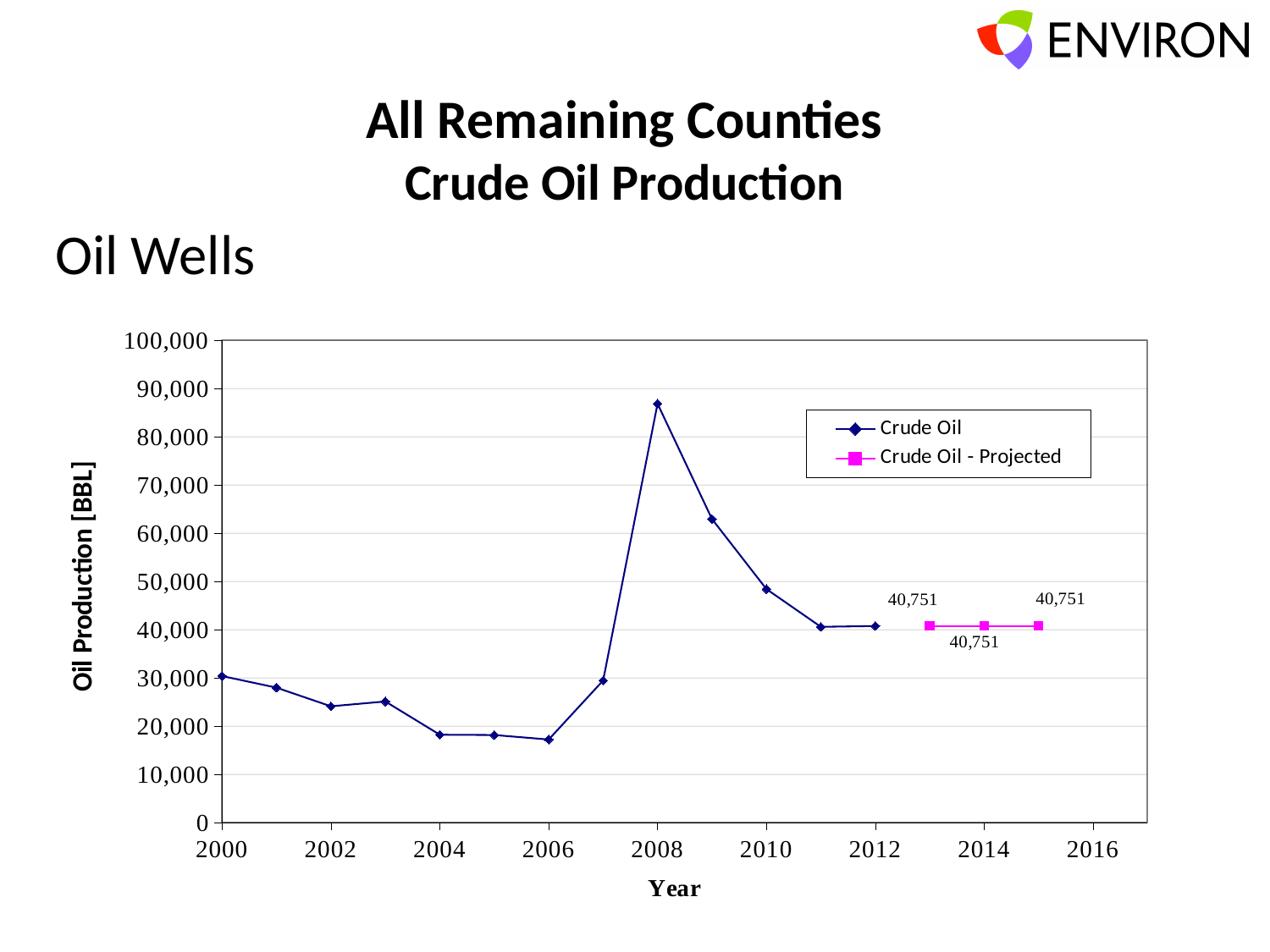
Is the crude oil production value for 2010 greater or less than 50,000? less How many series does the legend list? 2 What is the projected crude oil production value for 2015? 40,751 Which year has the larger crude oil production, 2008 or 2009? 2008 Is the crude oil production value for 2008 greater or less than 80,000? greater How many data points does the Crude Oil - Projected series have? 3 What type of chart is shown on the slide? line chart Is the crude oil production value for 2006 greater or less than 20,000? less What is the projected crude oil production value for 2014? 40,751 In which year is crude oil production highest? 2008 Does crude oil production rise or fall from 2008 to 2011? fall What is the label on the y axis? Oil Production [BBL]